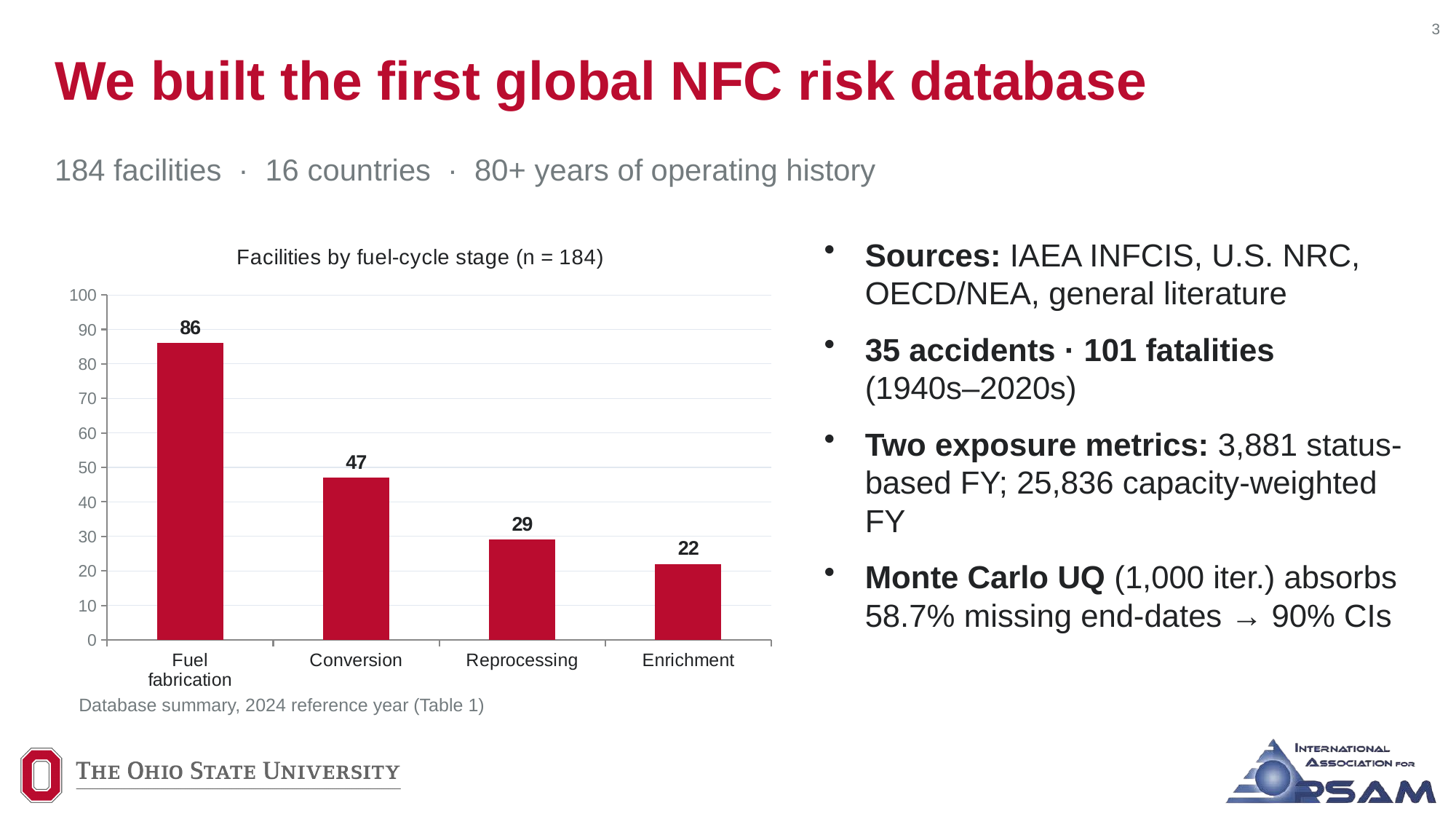
What is the value for Conversion? 47 Which fuel-cycle stage has the lowest number of facilities? Enrichment Which is larger, the value for Reprocessing or the value for Enrichment? Reprocessing What is the difference between the values for Fuel fabrication and Conversion? 39 What is the value for Fuel fabrication? 86 How many fuel-cycle stages are shown on the x axis? 4 Is the value for Conversion greater or less than 50? less What is the value for Enrichment? 22 Which fuel-cycle stage has the highest number of facilities? Fuel fabrication What is the value for Reprocessing? 29 What is the title of the chart? Facilities by fuel-cycle stage (n = 184) What kind of chart is shown on the slide? Bar chart